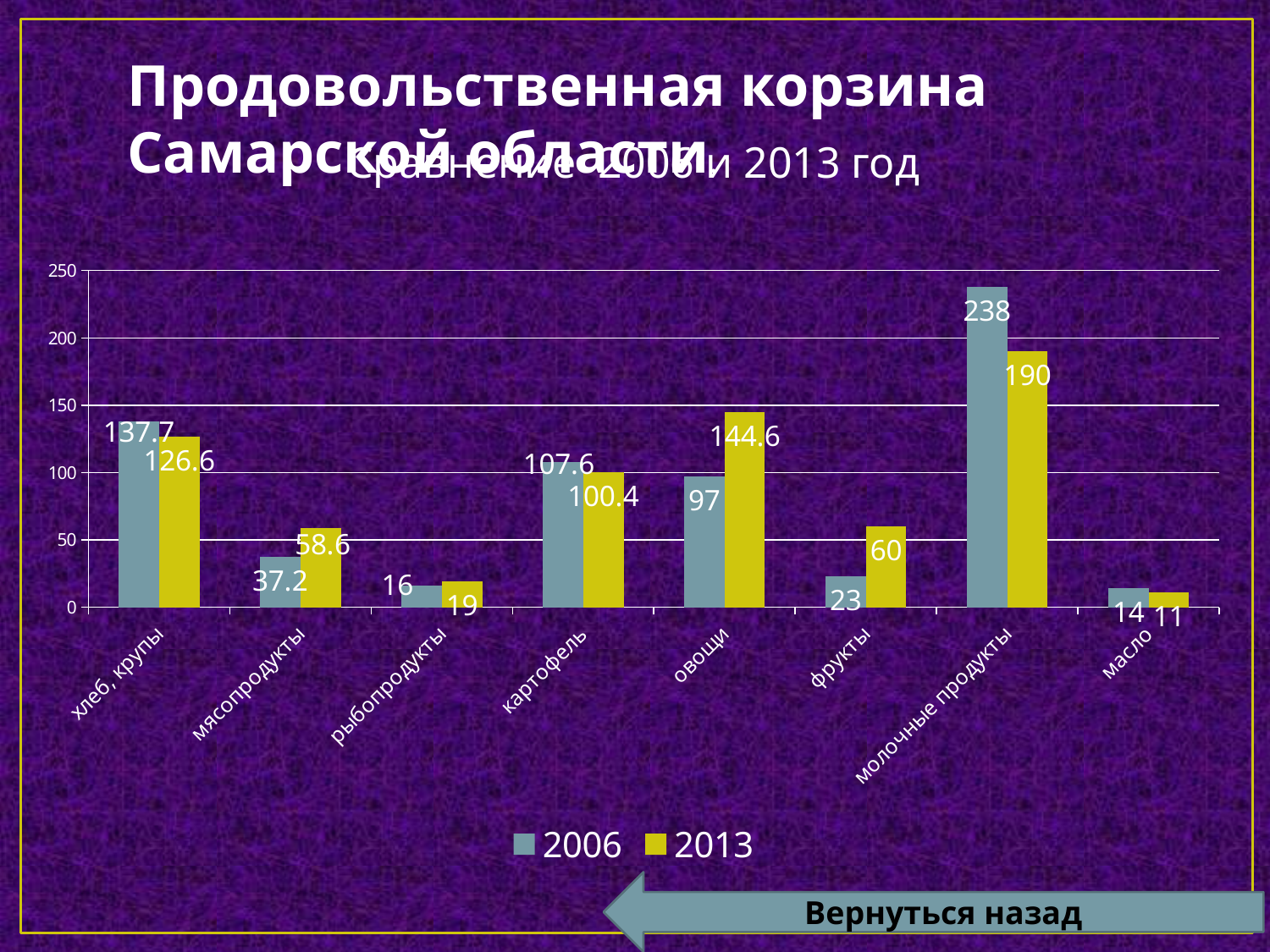
Which is larger for картофель, the 2006 value or the 2013 value? 2006 What is the difference between the 2006 and 2013 values for фрукты? 37 What is the 2013 value for овощи? 144.6 Which category has the lowest 2006 value? масло Which category has the highest 2013 value? молочные продукты What kind of chart is shown on the slide? bar chart What is the 2006 value for молочные продукты? 238 How many categories are shown on the x axis? 8 How many series does the legend list? 2 What is the difference between the 2006 and 2013 values for молочные продукты? 48 Is the 2013 value for хлеб, крупы greater or less than 100? greater What is the 2013 value for мясопродукты? 58.6